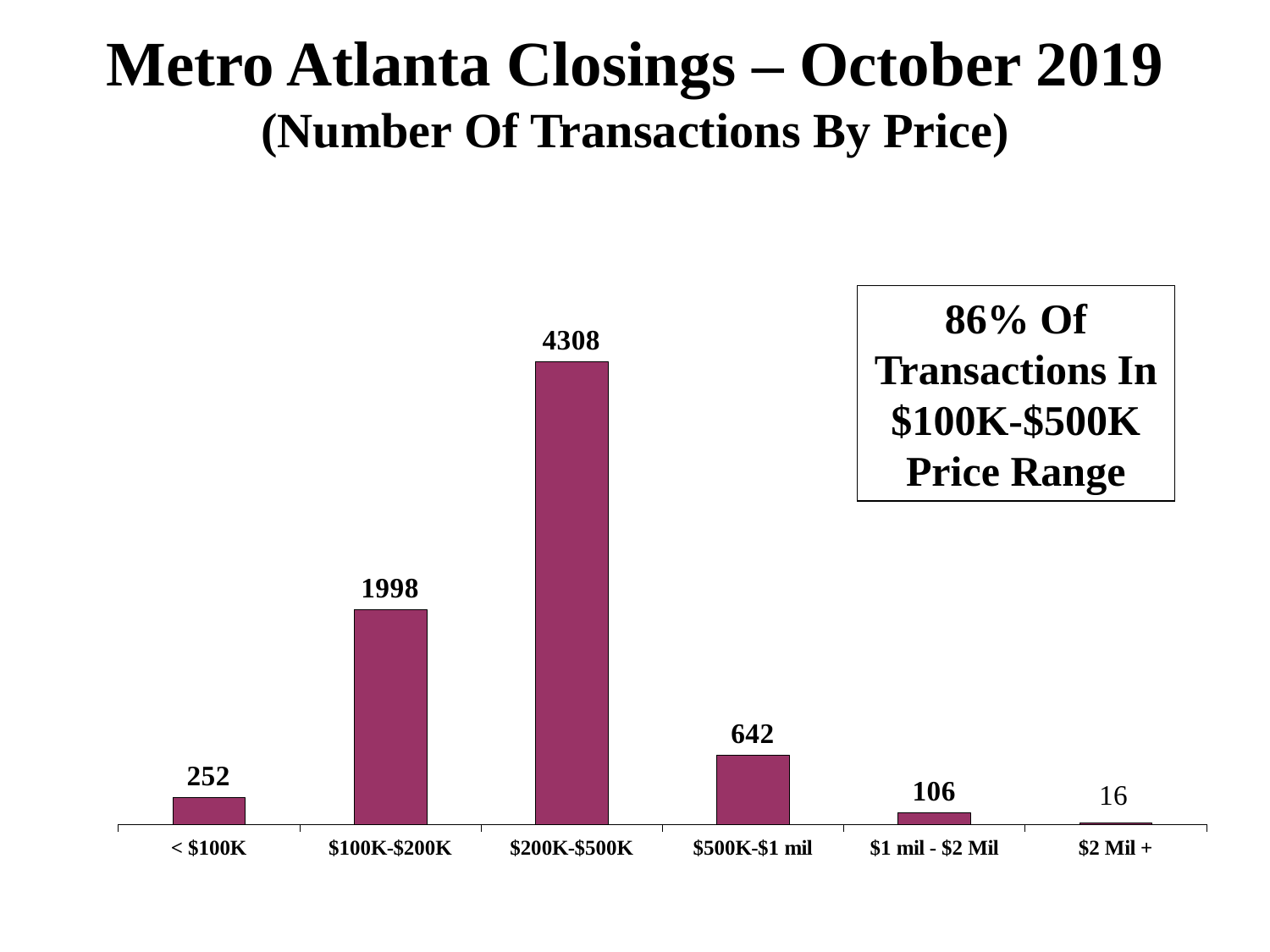
Which price range has the highest number of transactions? $200K-$500K How many transactions were in the $200K-$500K price range? 4308 Which has more transactions: $500K-$1 mil or < $100K? $500K-$1 mil Which price range has the lowest number of transactions? $2 Mil + What type of chart is shown on the slide? Bar chart What is the difference between the $500K-$1 mil and $1 mil - $2 Mil transaction counts? 536 What is the number of transactions for the < $100K category? 252 According to the text box on the slide, what percentage of transactions were in the $100K-$500K price range? 86% How many price range categories are shown on the chart? 6 What is the total number of transactions in the $100K-$200K and $200K-$500K ranges combined? 6306 How many transactions were in the $1 mil - $2 Mil range? 106 What is the difference between the number of transactions in the $200K-$500K range and the $100K-$200K range? 2310